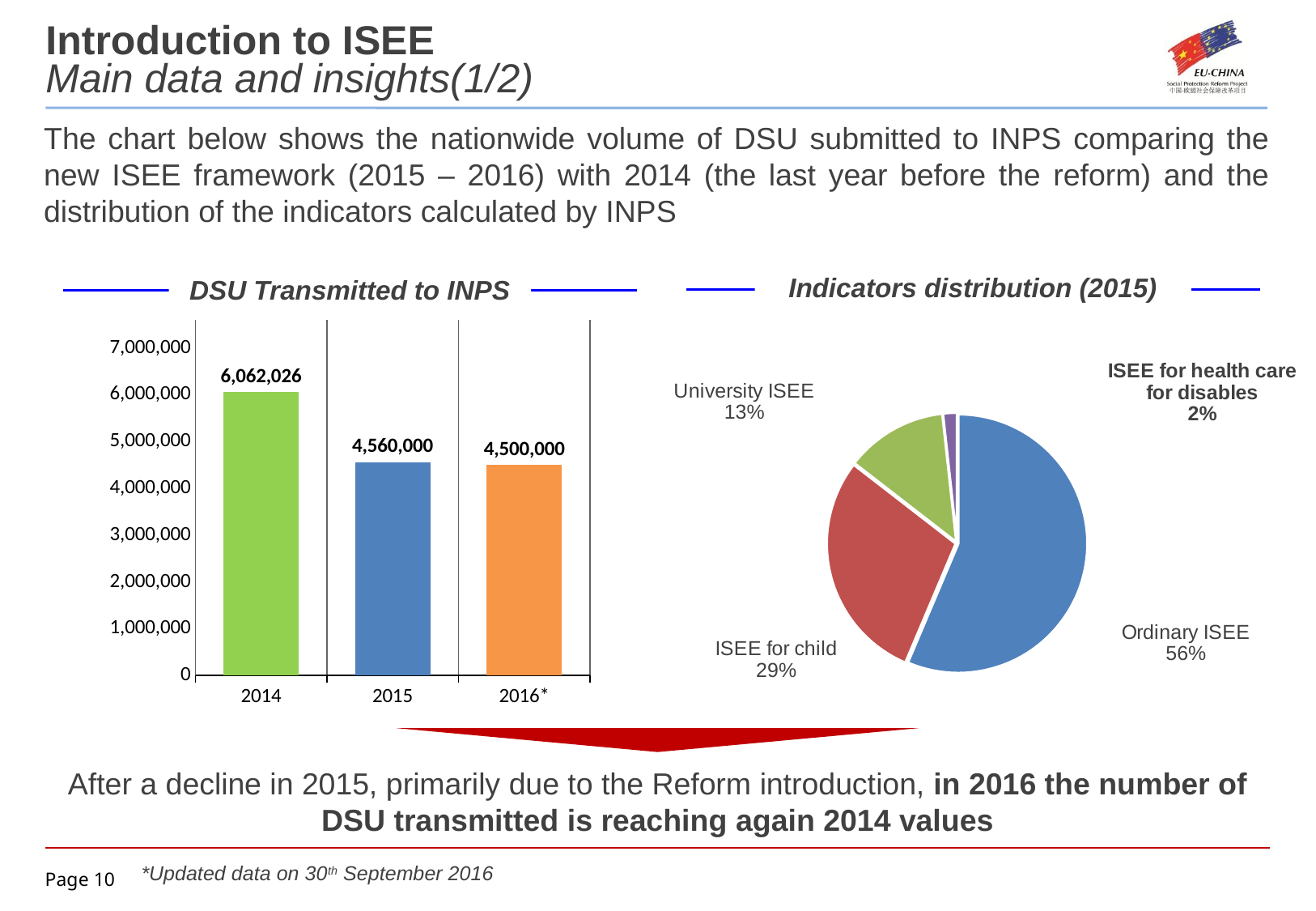
In the 'DSU Transmitted to INPS' chart, how many years are shown on the x axis? 3 In the 'DSU Transmitted to INPS' chart, which year has the lowest value? 2016* What kind of chart is 'DSU Transmitted to INPS'? bar chart In the 'DSU Transmitted to INPS' chart, what is the value for 2015? 4,560,000 In the 'DSU Transmitted to INPS' chart, which year has the highest value? 2014 In the 'Indicators distribution (2015)' chart, what share does ISEE for child have? 29% In the 'DSU Transmitted to INPS' chart, is the value for 2014 greater or less than 6,000,000? greater In the 'Indicators distribution (2015)' chart, what share does Ordinary ISEE have? 56% In the 'DSU Transmitted to INPS' chart, what is the value for 2014? 6,062,026 What kind of chart is 'Indicators distribution (2015)'? pie chart In the 'DSU Transmitted to INPS' chart, what is the difference between the 2014 and 2015 values? 1,502,026 In the 'Indicators distribution (2015)' chart, which category has the smallest slice? ISEE for health care for disables